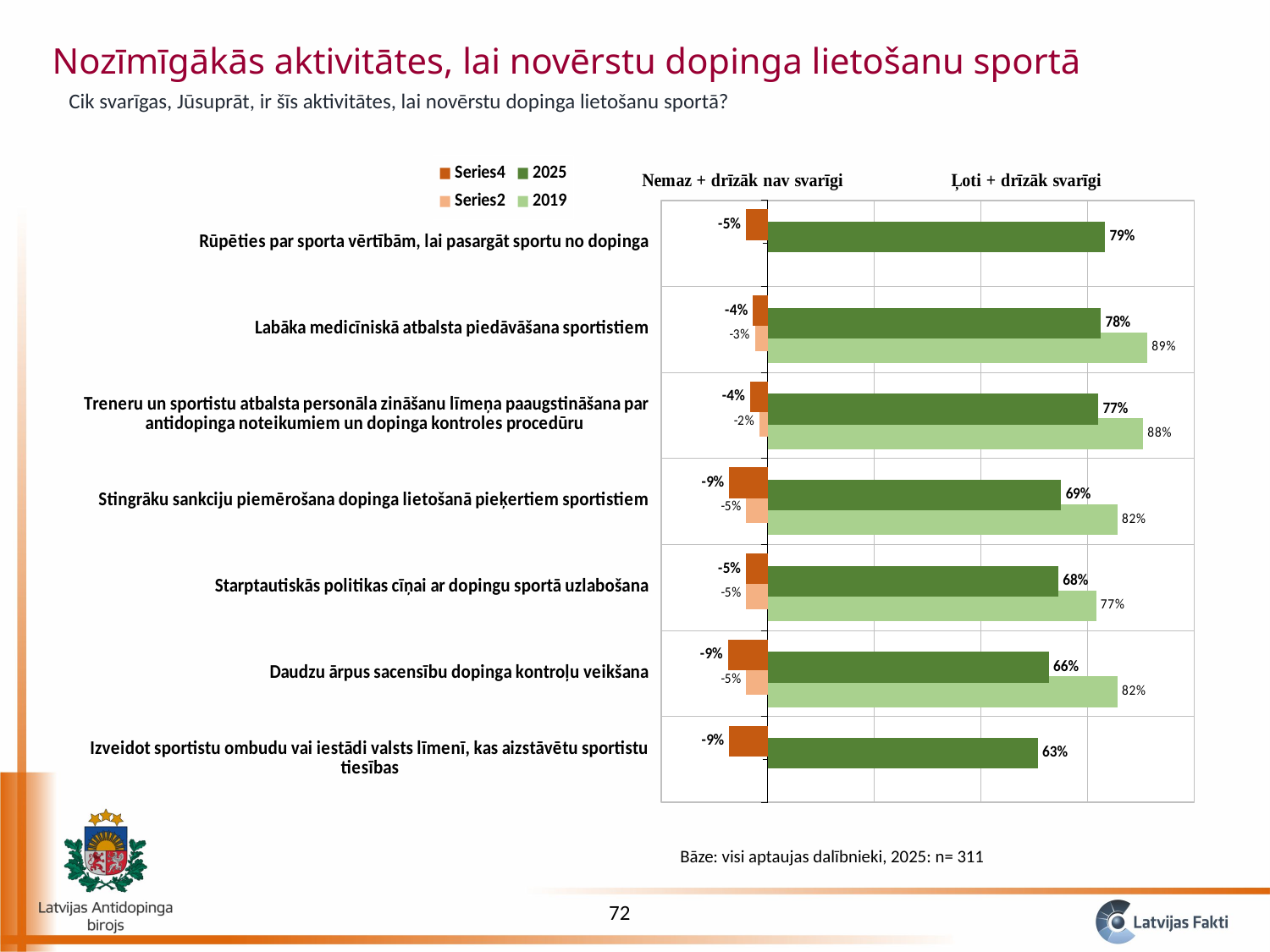
What is the Series4 (negative) value for "Treneru un sportistu atbalsta personāla zināšanu līmeņa paaugstināšana par antidopinga noteikumiem un dopinga kontroles procedūru"? -4% Which is larger: the 2025 value for "Daudzu ārpus sacensību dopinga kontroļu veikšana" or the 2025 value for "Starptautiskās politikas cīņai ar dopingu sportā uzlabošana"? Starptautiskās politikas cīņai ar dopingu sportā uzlabošana What is the label above the right-hand side of the chart? Ļoti + drīzāk svarīgi Which category has the lowest 2025 value? Izveidot sportistu ombudu vai iestādi valsts līmenī, kas aizstāvētu sportistu tiesības What is the 2025 value for "Izveidot sportistu ombudu vai iestādi valsts līmenī, kas aizstāvētu sportistu tiesības"? 63% How many categories are shown in the chart? 7 How many series does the legend list? 4 What kind of chart is shown on the slide? Bar chart Which category has the highest 2025 value? Rūpēties par sporta vērtībām, lai pasargāt sportu no dopinga What is the difference between the 2019 and 2025 values for "Stingrāku sankciju piemērošana dopinga lietošanā pieķertiem sportistiem"? 13 percentage points What is the 2019 value for "Labāka medicīniskā atbalsta piedāvāšana sportistiem"? 89% What is the 2025 value for "Rūpēties par sporta vērtībām, lai pasargāt sportu no dopinga"? 79%